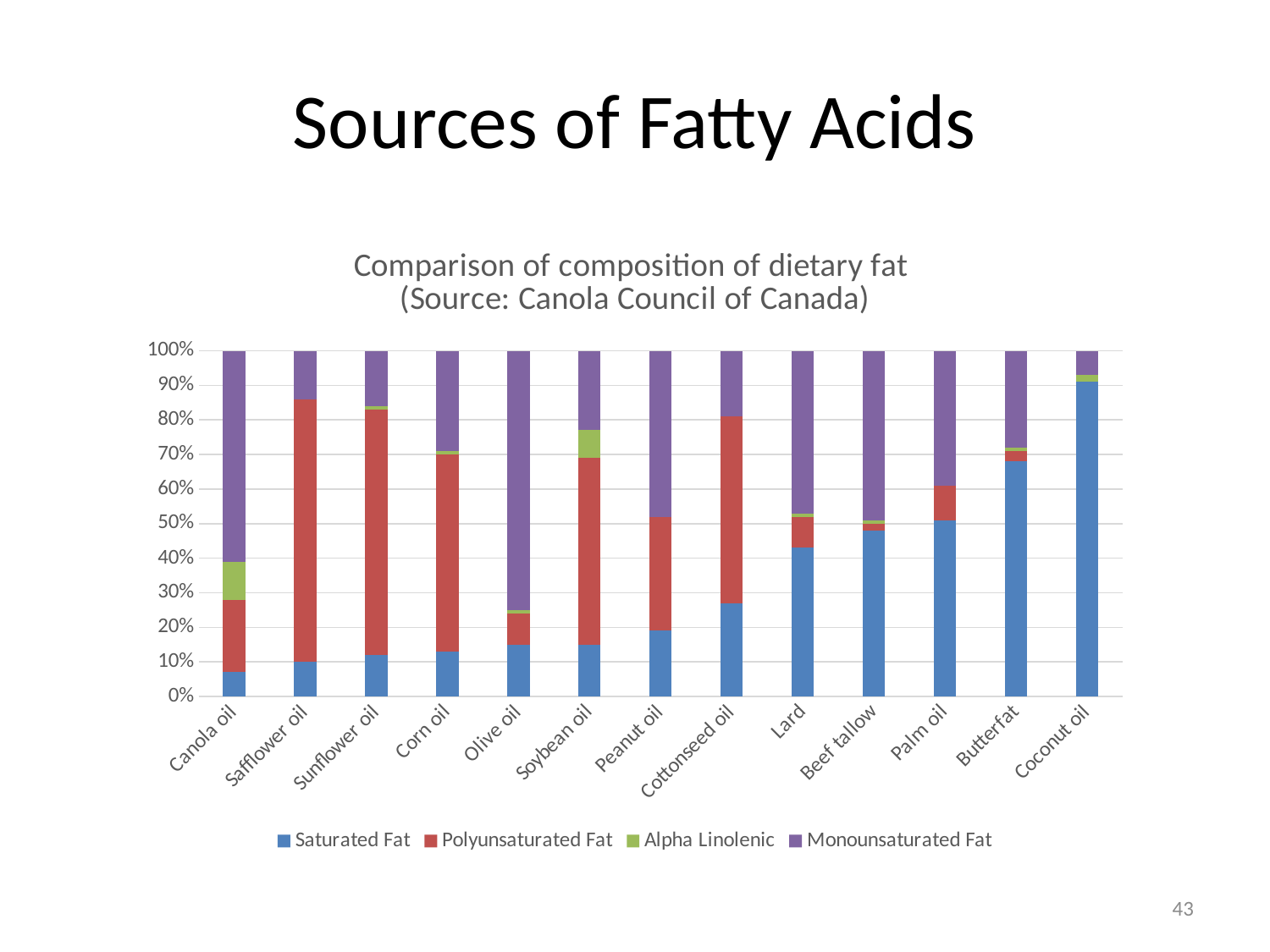
What is the title of the chart? Comparison of composition of dietary fat (Source: Canola Council of Canada) Which has a larger share of Saturated Fat, Butterfat or Palm oil? Butterfat Which colour represents Saturated Fat in the legend? Blue Which fat source has the lowest share of Saturated Fat? Canola oil Which fat source has the largest share of Monounsaturated Fat? Olive oil Is the Saturated Fat share for Lard greater or less than 50%? less Which fat source has the highest share of Saturated Fat? Coconut oil Is the Saturated Fat share for Coconut oil greater or less than 80%? greater How many series does the legend list? 4 How many fat sources (categories) are shown on the x axis? 13 What kind of chart is shown on the slide? Stacked bar chart Is the Saturated Fat share for Canola oil greater or less than 10%? less